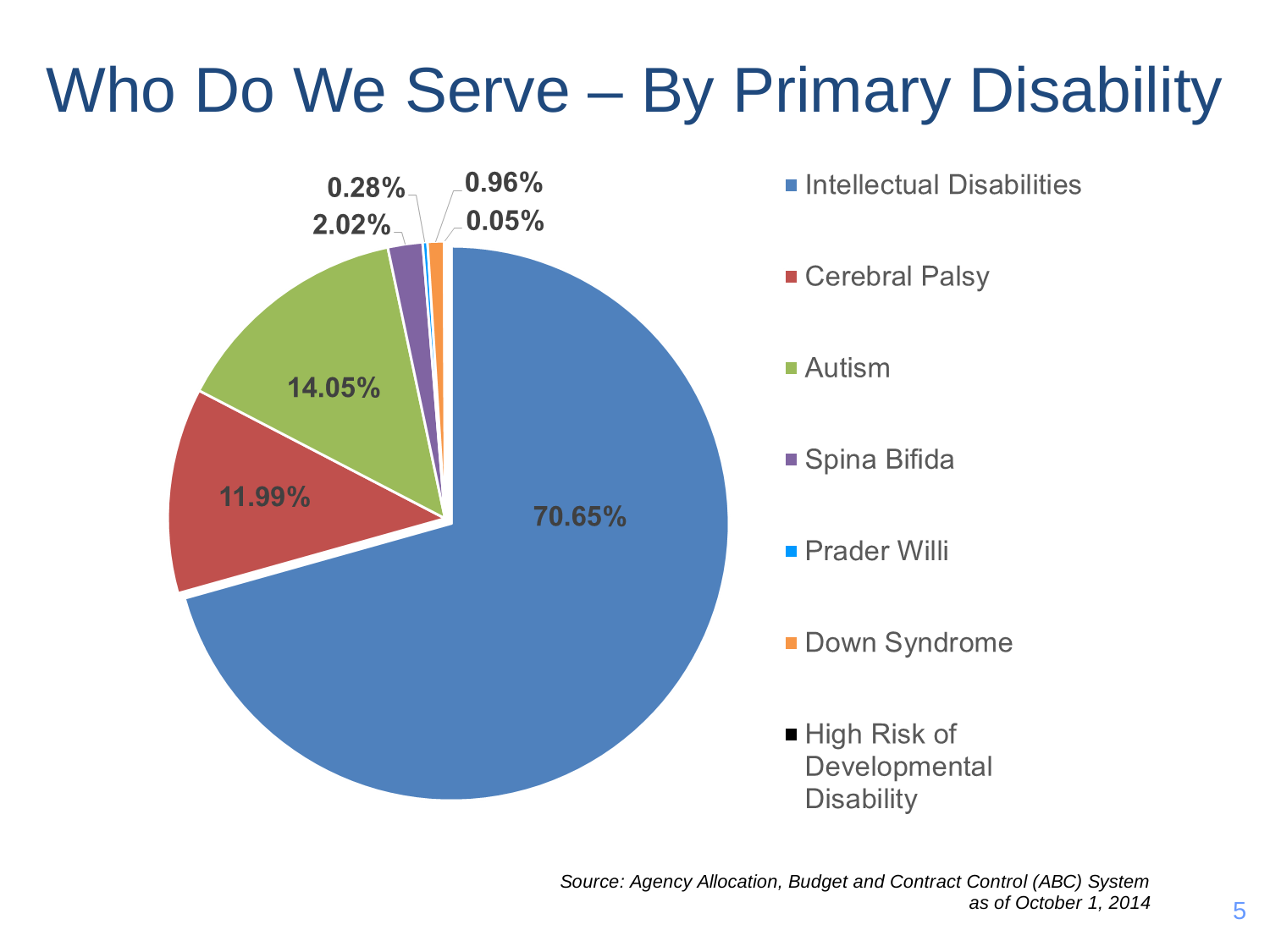
Which is larger, the share for Autism or the share for Cerebral Palsy? Autism What kind of chart is shown on the slide? Pie chart What share of the pie does Intellectual Disabilities represent? 70.65% How many categories does the legend list? 7 What is the title of the slide containing the chart? Who Do We Serve – By Primary Disability Which primary disability category has the smallest share of the pie? High Risk of Developmental Disability What percentage is shown for Down Syndrome? 0.96% Which primary disability category has the largest share of the pie? Intellectual Disabilities What percentage is shown for Autism? 14.05% What percentage is shown for Cerebral Palsy? 11.99% What percentage is shown for Spina Bifida? 2.02% What is the difference in percentage points between Autism and Cerebral Palsy? 2.06